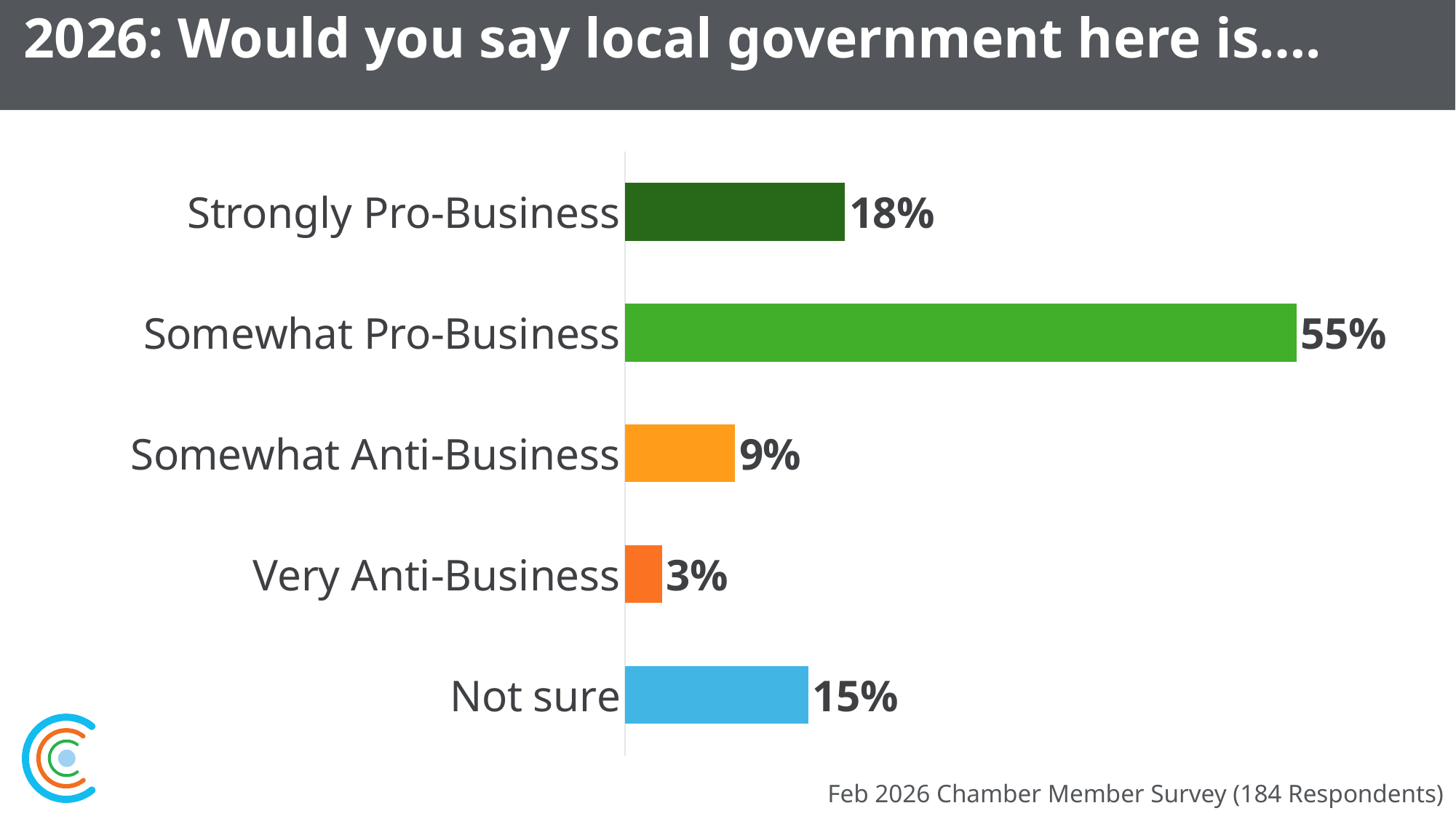
According to the footnote, how many respondents took part in the survey? 184 What percentage of respondents answered Not sure? 15% What percentage of respondents said local government is Strongly Pro-Business? 18% Which response category has the highest percentage? Somewhat Pro-Business What percentage of respondents said local government is Very Anti-Business? 3% What percentage of respondents said local government is Somewhat Anti-Business? 9% Which response category has the lowest percentage? Very Anti-Business What percentage of respondents said local government is Somewhat Pro-Business? 55% What kind of chart is shown on the slide? Bar chart Which is larger, the percentage for Strongly Pro-Business or for Not sure? Strongly Pro-Business How many response categories are shown in the chart? 5 What is the difference in percentage points between Somewhat Pro-Business and Strongly Pro-Business? 37